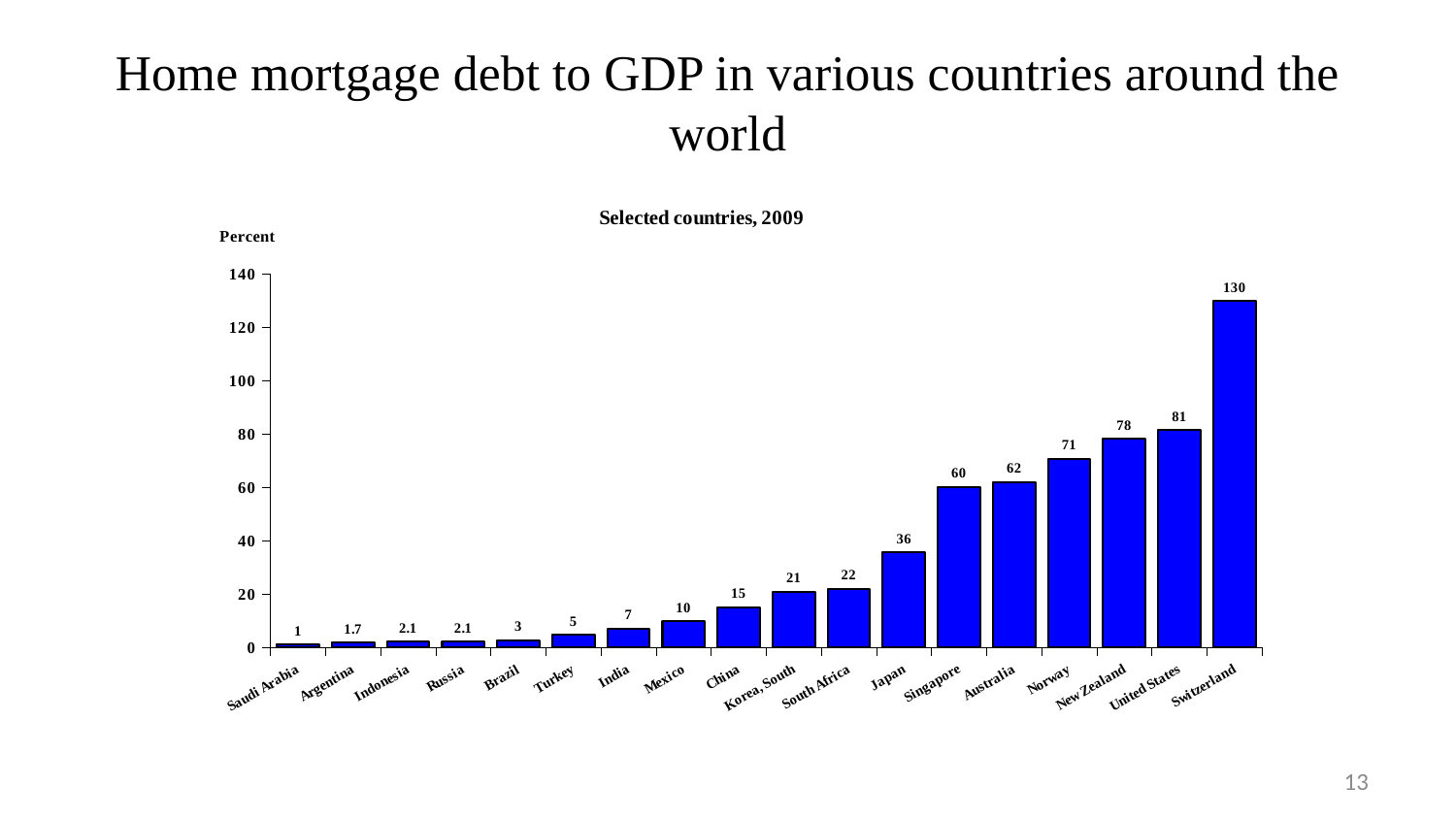
Which has a larger value, Norway or New Zealand? New Zealand What is the difference between the values for Australia and Singapore? 2 Is the value for Switzerland greater or less than 120? greater What is the difference between the values for Switzerland and the United States? 49 Do the values rise or fall from left to right along the x axis? Rise How many countries are shown on the chart? 18 Which country has the highest value? Switzerland What is the value for Japan? 36 What is the value for Argentina? 1.7 What kind of chart is shown on the slide? Bar chart Which country has the lowest value? Saudi Arabia What is the value for the United States? 81